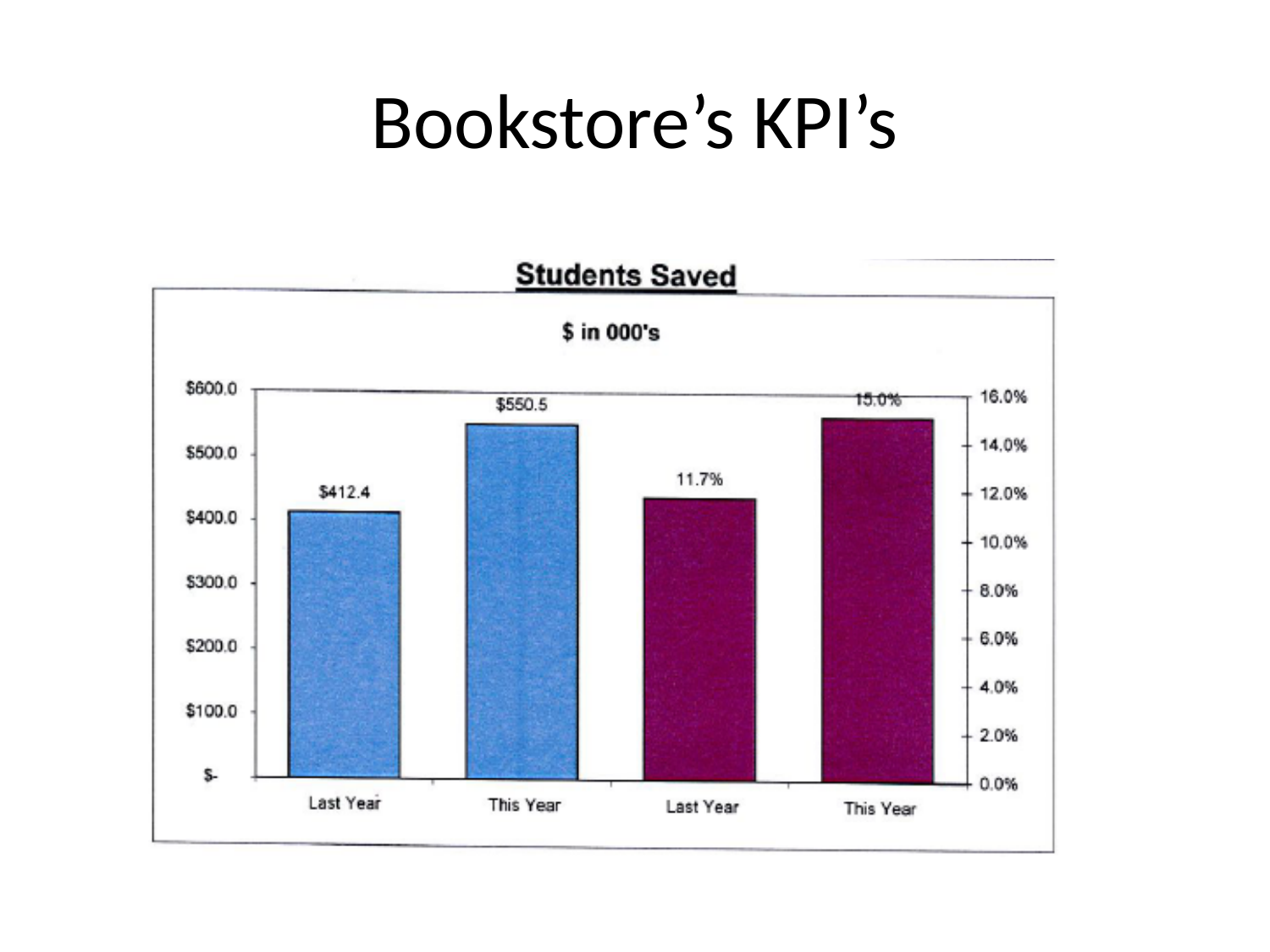
What is the difference between the This Year and Last Year percentage values? 3.3% What is the title of the chart? Students Saved What is the difference between the This Year and Last Year dollar values? $138.1 What is the percentage value for Last Year in the Students Saved chart? 11.7% What unit is stated in the chart's subtitle? $ in 000's What is the percentage value for This Year in the Students Saved chart? 15.0% How many bars are plotted in the chart? 4 What is the dollar value for This Year in the Students Saved chart? $550.5 Which of the two dollar bars is larger, Last Year or This Year? This Year What kind of chart is shown on the slide? bar chart What is the dollar value for Last Year in the Students Saved chart? $412.4 Is the Last Year dollar value greater or less than $500.0? less